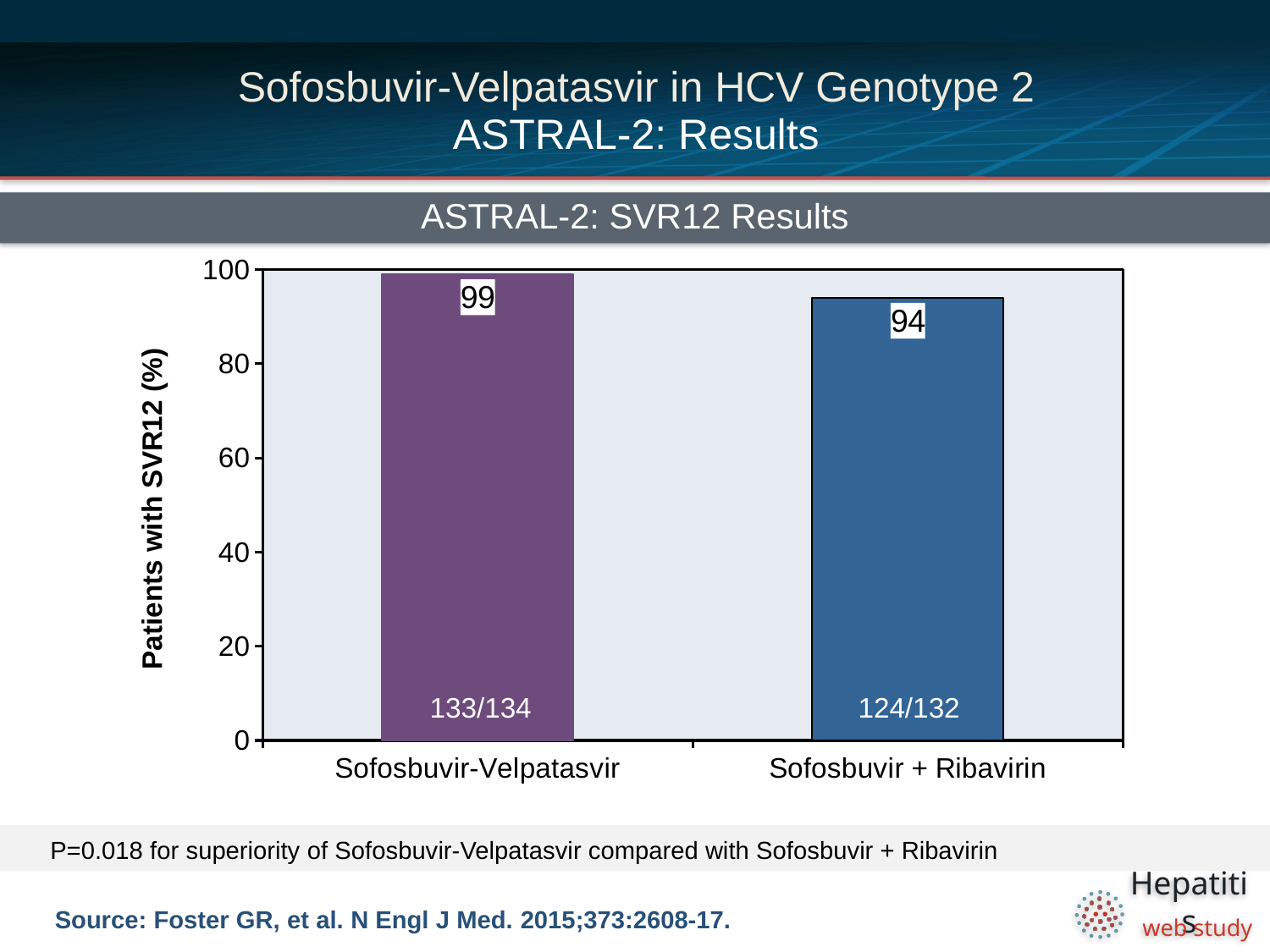
What is the difference in SVR12 rate between Sofosbuvir-Velpatasvir and Sofosbuvir + Ribavirin? 5 What is the SVR12 rate for Sofosbuvir-Velpatasvir? 99 How many treatment arms are shown in the chart? 2 What is the label of the y-axis? Patients with SVR12 (%) How many patients achieved SVR12 out of the total in the Sofosbuvir + Ribavirin arm? 124/132 What kind of chart is shown on the slide? Bar chart What is the title of the chart? ASTRAL-2: SVR12 Results Is the SVR12 rate for Sofosbuvir + Ribavirin greater or less than 80? greater What is the SVR12 rate for Sofosbuvir + Ribavirin? 94 How many patients achieved SVR12 out of the total in the Sofosbuvir-Velpatasvir arm? 133/134 Which treatment arm has the lower SVR12 rate? Sofosbuvir + Ribavirin Which treatment arm has the higher SVR12 rate? Sofosbuvir-Velpatasvir